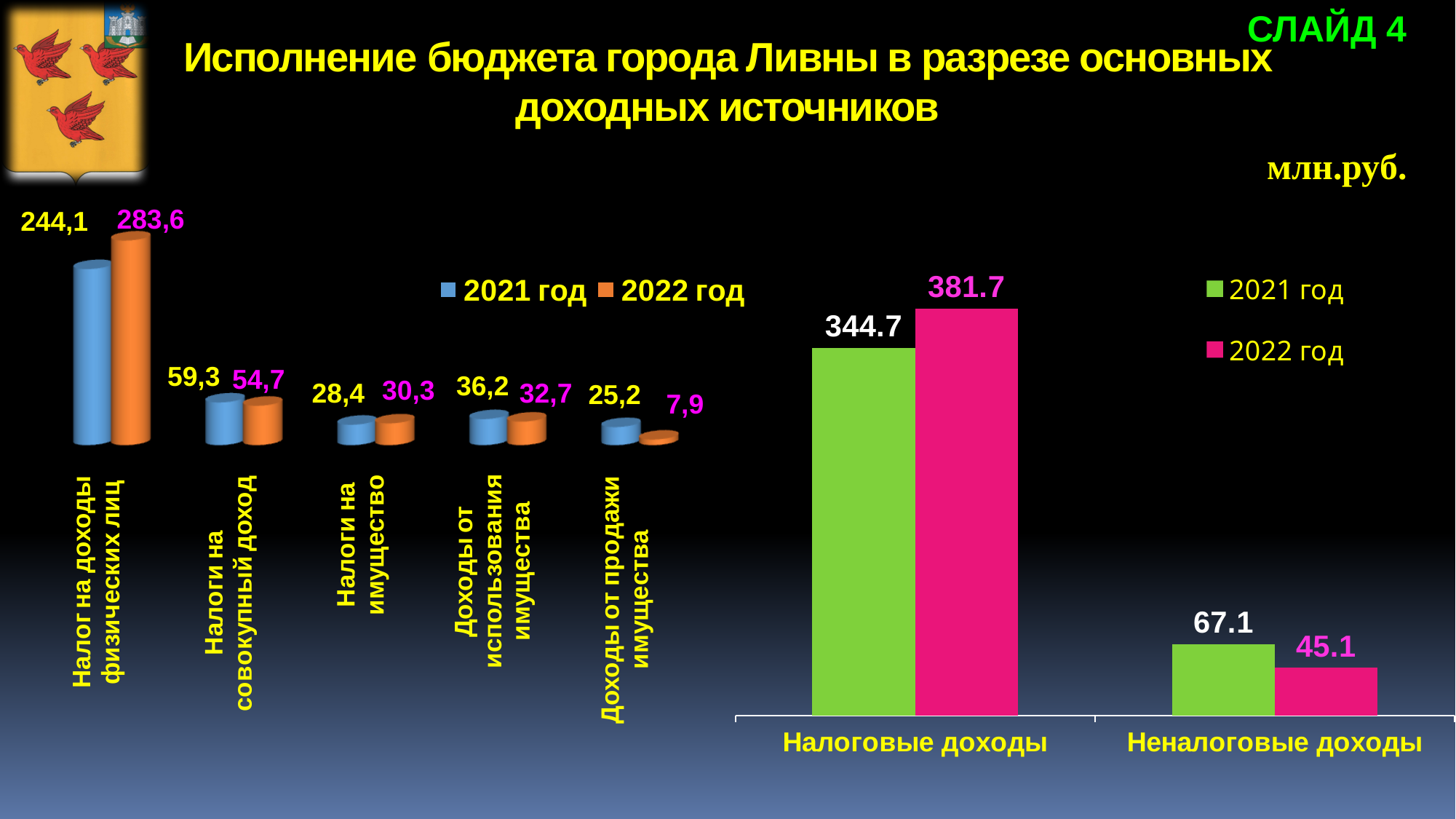
In the left chart, what is the 2022 год value for Налог на доходы физических лиц? 283,6 In the left chart, what is the difference between the 2021 год and 2022 год values for Доходы от продажи имущества? 17,3 In the left chart, which category has the lowest 2022 год value? Доходы от продажи имущества In the left chart, what is the 2022 год value for Налоги на имущество? 30,3 In the right chart, what is the difference between the 2022 год and 2021 год values for Налоговые доходы? 37.0 In the right chart, what is the 2021 год value for Неналоговые доходы? 67.1 In the right chart, what is the 2022 год value for Налоговые доходы? 381.7 How many series does the legend of the right chart list? 2 In the left chart, which category has the highest 2021 год value? Налог на доходы физических лиц How many categories are shown in the left chart? 5 In the left chart, what is the 2021 год value for Доходы от продажи имущества? 25,2 In the left chart, which is larger for Налоги на совокупный доход: the 2021 год value or the 2022 год value? 2021 год